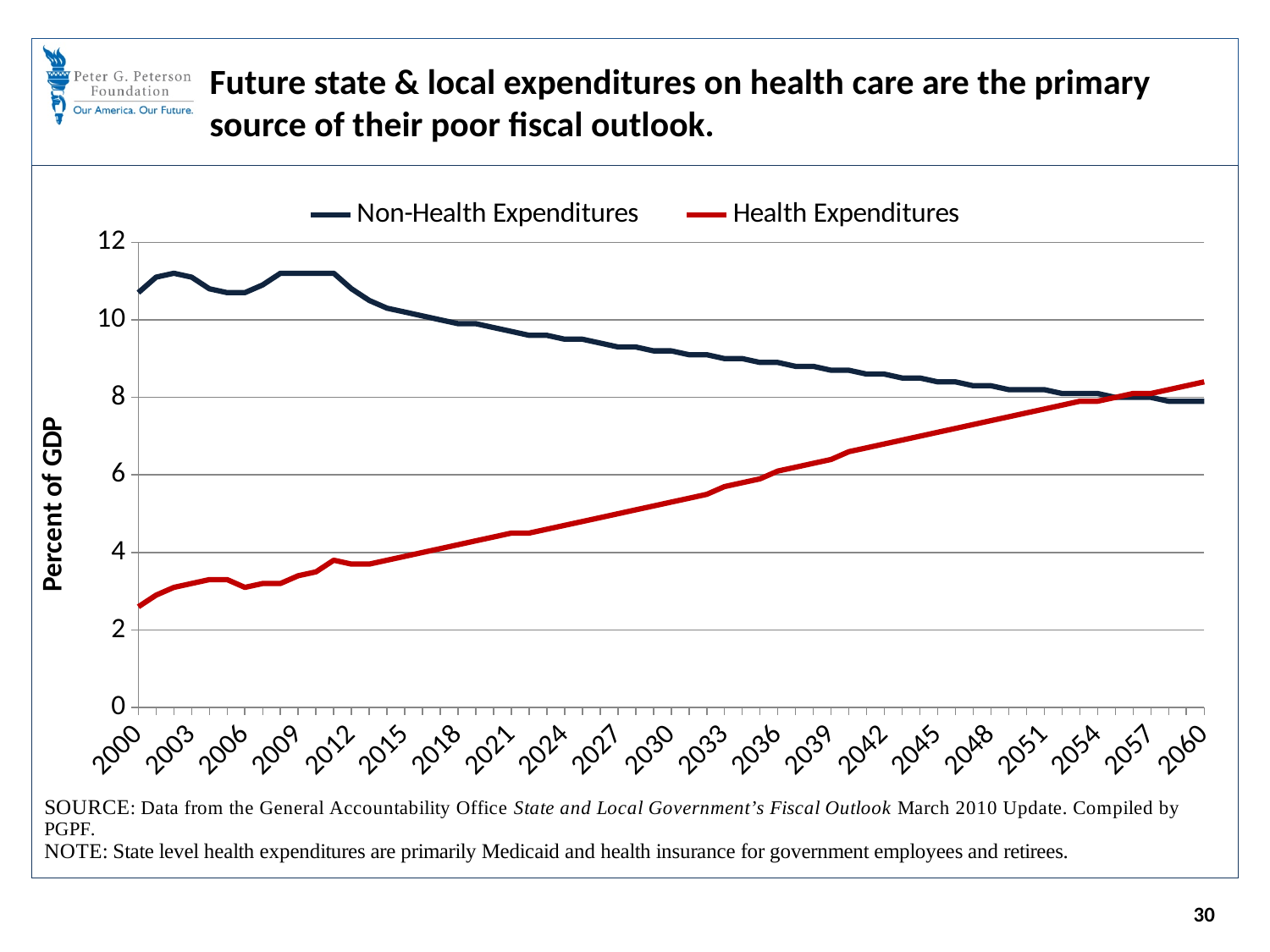
What is the label on the vertical axis? Percent of GDP Which series is drawn in red? Health Expenditures What kind of chart is shown on the slide? Line chart Is the value for Non-Health Expenditures in 2030 greater or less than 10? less Is the value for Health Expenditures in 2060 greater or less than 8? greater Is the value for Non-Health Expenditures in 2000 greater or less than 10? greater Do Non-Health Expenditures rise or fall overall from 2012 to 2060? Fall How many series does the legend list? 2 In 2060, which series has the larger value, Non-Health Expenditures or Health Expenditures? Health Expenditures Do Health Expenditures rise or fall from 2000 to 2060? Rise In 2000, which series has the larger value, Non-Health Expenditures or Health Expenditures? Non-Health Expenditures